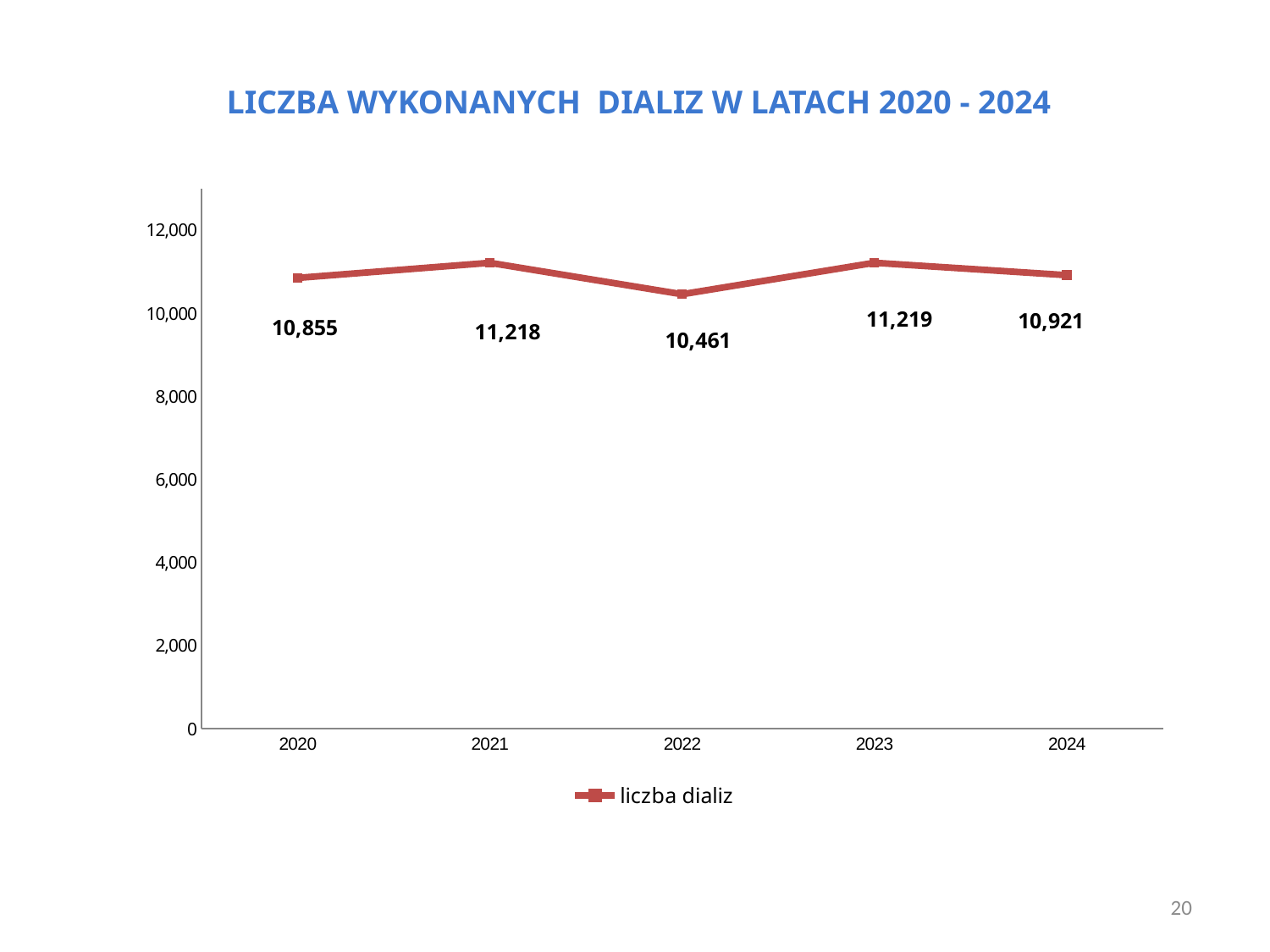
By how much did the value change from 2020 to 2021? 363 How many series does the legend list? 1 What is the difference between the values for 2021 and 2022? 757 What kind of chart is shown on the slide? line chart Is the value for 2022 greater or less than 10,000? greater How many years are plotted on the x axis? 5 Which year has the lowest number of dialyses? 2022 What is the value plotted for 2022? 10,461 What is the value plotted for 2024? 10,921 Which is larger, the value for 2020 or the value for 2022? 2020 Does the value rise or fall from 2021 to 2022? fall What is the number of dialyses (liczba dializ) in 2020? 10,855